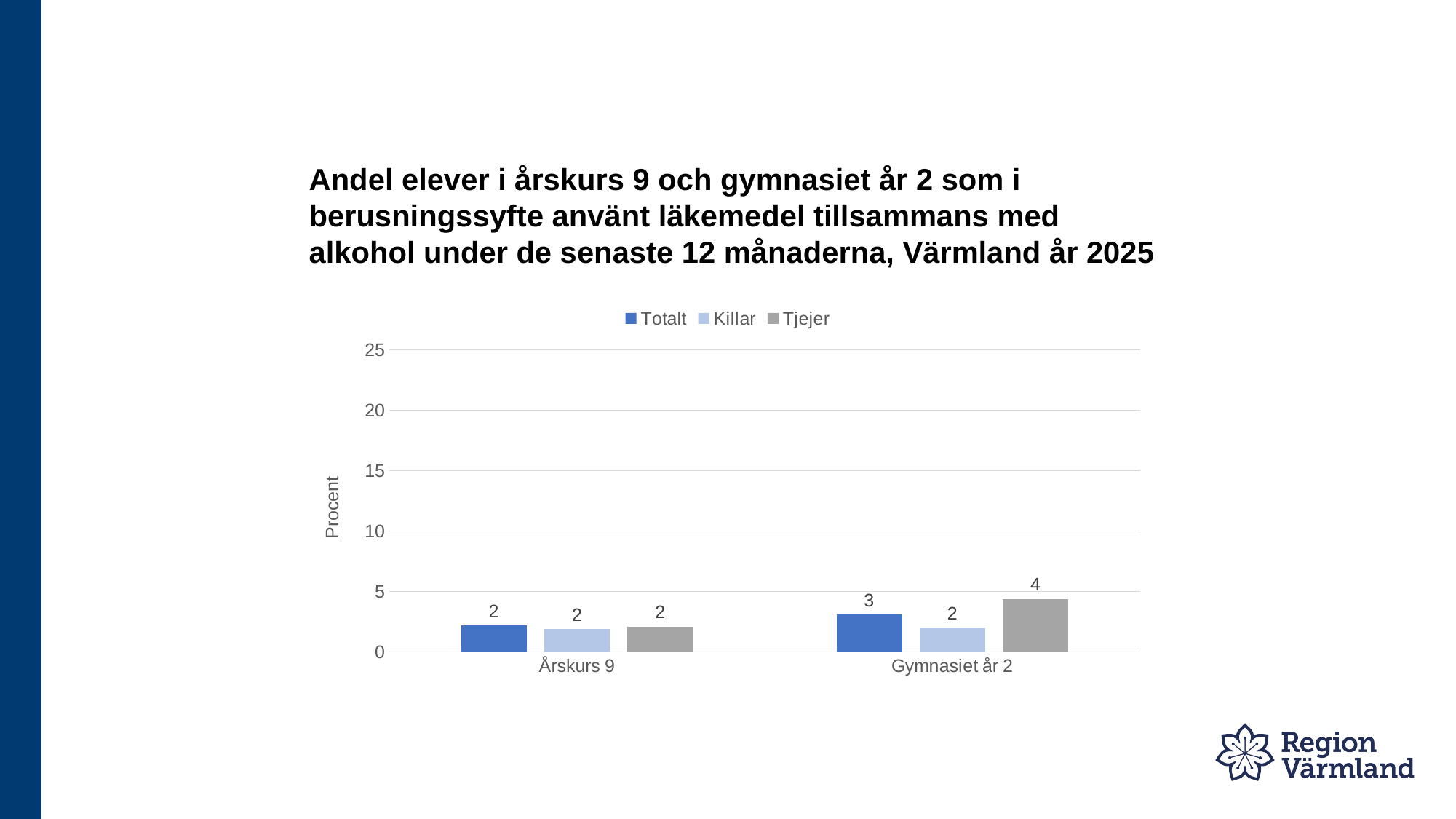
Is the Tjejer value larger in Årskurs 9 or in Gymnasiet år 2? Gymnasiet år 2 Which series has the highest value in Gymnasiet år 2? Tjejer How many categories are shown on the x axis? 2 What is the value for Killar in Årskurs 9? 2 What kind of chart is shown on the slide? Bar chart Is the value for Tjejer in Gymnasiet år 2 greater or less than 5? less How many series does the legend list? 3 What is the difference between the Tjejer and Killar values in Gymnasiet år 2? 2 What is the value for Tjejer in Gymnasiet år 2? 4 What is the value for Totalt in Gymnasiet år 2? 3 What is the label of the vertical axis? Procent Which series has the lowest value in Gymnasiet år 2? Killar